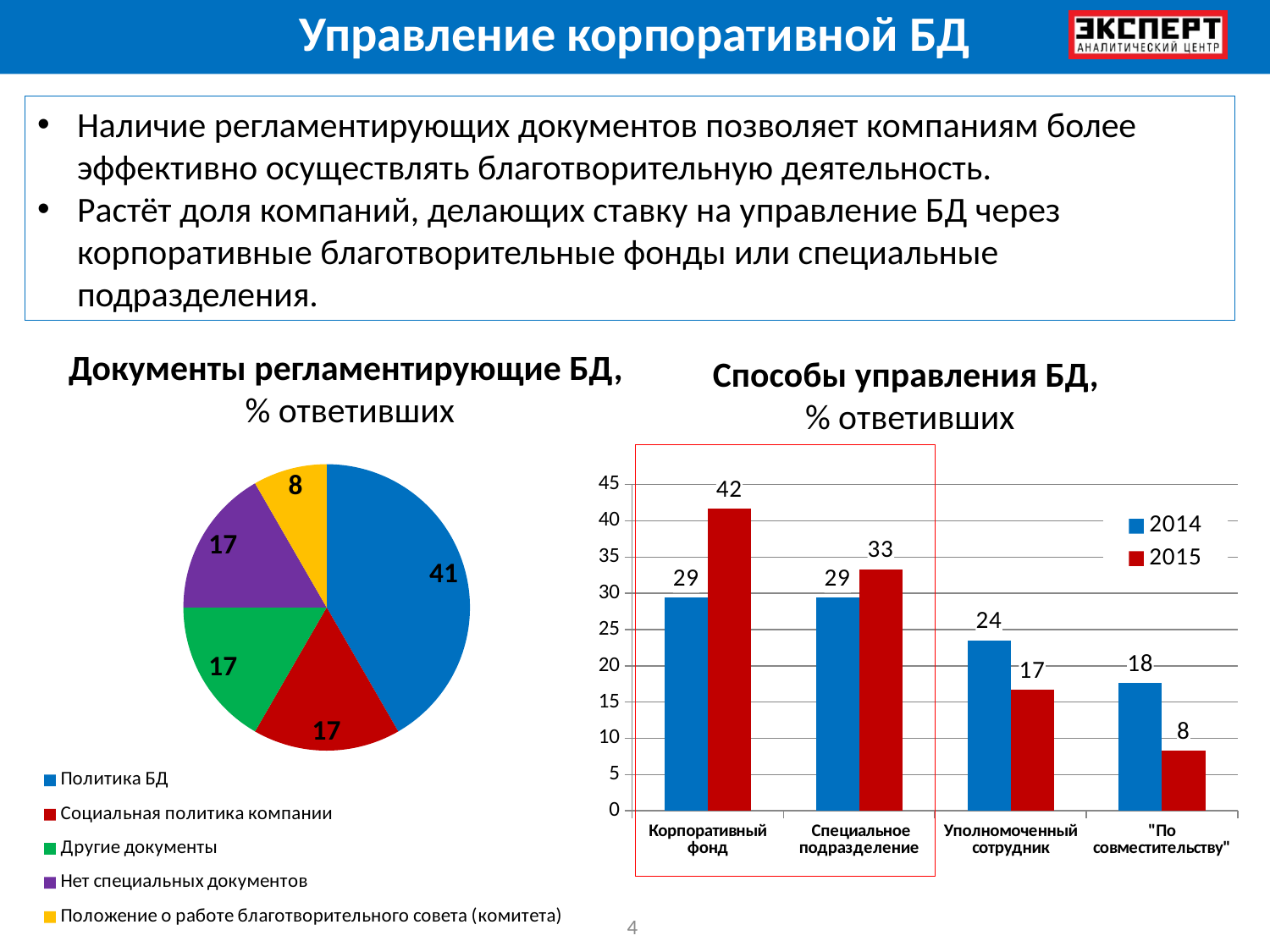
In the pie chart 'Документы регламентирующие БД', what is the value for 'Политика БД'? 41 In the chart 'Способы управления БД', which category has the lowest value for 2015? "По совместительству" In the chart 'Способы управления БД', which category has the highest value for 2015? Корпоративный фонд In the chart 'Способы управления БД', which is larger for 'Уполномоченный сотрудник': the 2014 value or the 2015 value? 2014 In the chart 'Способы управления БД', what is the value for 'Уполномоченный сотрудник' in 2014? 24 How many series does the legend of the chart 'Способы управления БД' list? 2 In the chart 'Способы управления БД', what is the difference between the 2015 and 2014 values for 'Корпоративный фонд'? 13 In the pie chart 'Документы регламентирующие БД', what colour is the slice for 'Другие документы'? Green What kind of chart is 'Документы регламентирующие БД'? Pie chart In the pie chart 'Документы регламентирующие БД', which slice is the smallest? Положение о работе благотворительного совета (комитета) How many categories are shown on the x axis of the chart 'Способы управления БД'? 4 In the chart 'Способы управления БД', what is the value for 'Корпоративный фонд' in 2015? 42